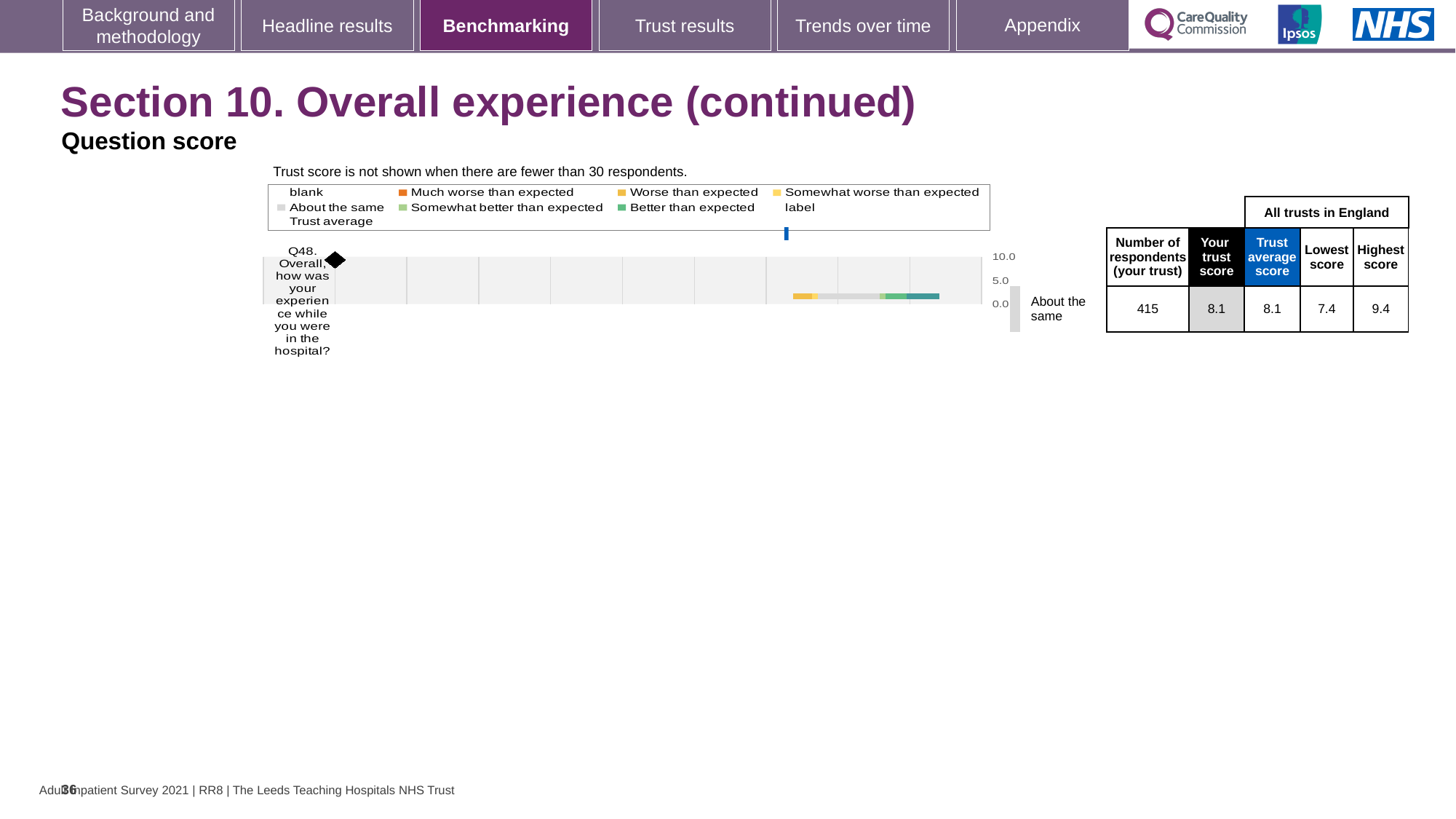
What benchmark category is the trust's Q48 result placed in? About the same What is the highest value shown on the chart's score axis? 10.0 What is the trust score for Q48 shown next to the chart? 8.1 What is the trust average score for Q48 across all trusts in England? 8.1 Which question is plotted on the chart? Q48. Overall, how was your experience while you were in the hospital? How many questions (categories) are plotted on the chart? 1 What is the highest score among all trusts in England for Q48? 9.4 What is the lowest score among all trusts in England for Q48? 7.4 What kind of chart is used to show the Q48 benchmarking result? bar chart How many respondents from the trust answered Q48? 415 What is the difference between the highest score and the lowest score for Q48 across all trusts in England? 2.0 Is the trust score for Q48 greater or less than 5.0? greater